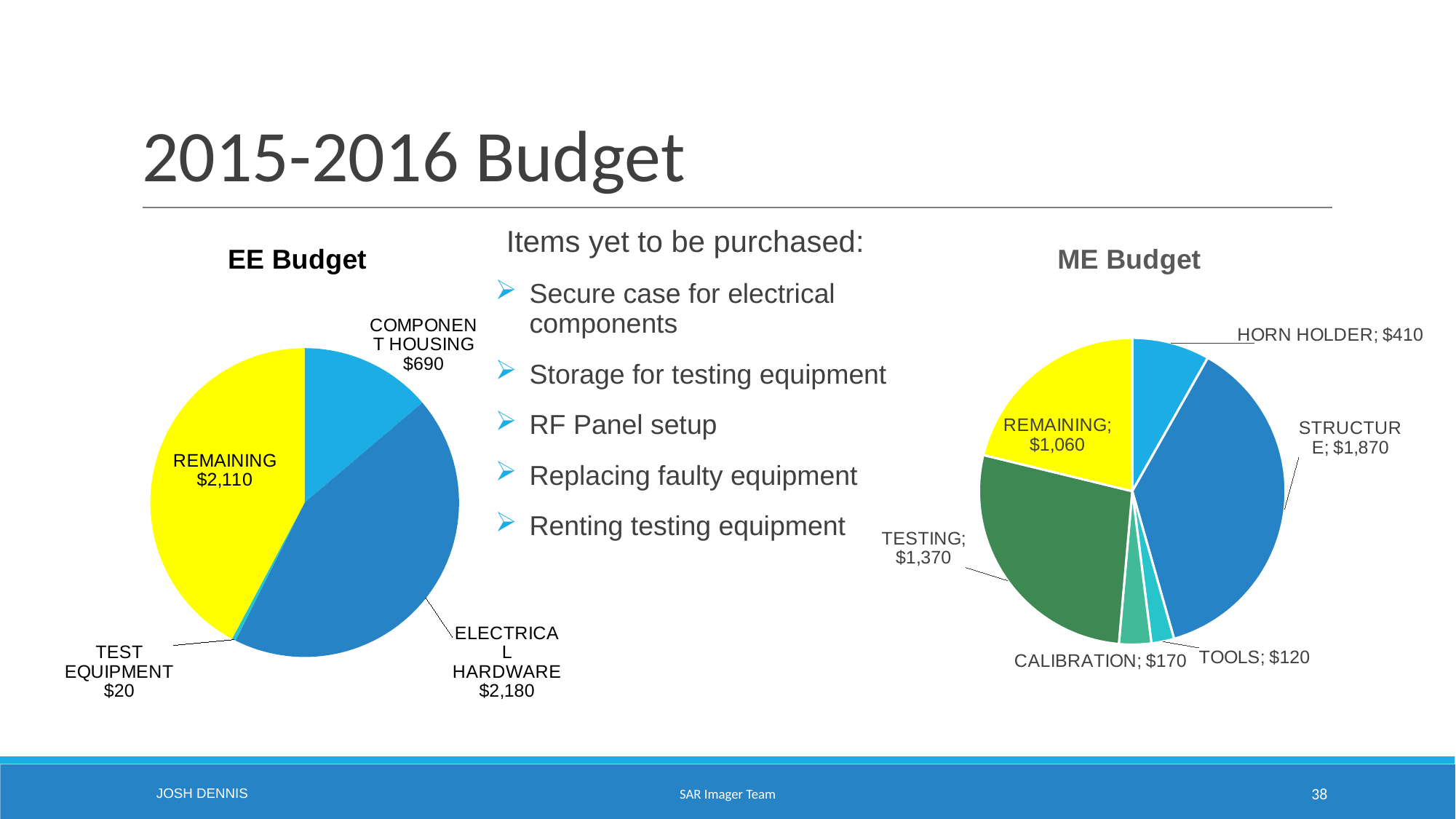
In the ME Budget chart, which category has the largest slice? Structure In the ME Budget chart, what is the difference between Horn Holder and Tools? $290 In the EE Budget chart, what is the value for Test Equipment? $20 In the EE Budget chart, what is the difference between Remaining and Component Housing? $1,420 What kind of chart is the EE Budget chart? pie chart In the ME Budget chart, which is larger, Testing or Remaining? Testing How many slices does the EE Budget pie chart have? 4 In the ME Budget chart, what is the value for Structure? $1,870 How many slices does the ME Budget pie chart have? 6 In the EE Budget chart, what is the value for Electrical Hardware? $2,180 In the EE Budget chart, which category has the smallest slice? Test Equipment In the ME Budget chart, what is the value for Calibration? $170